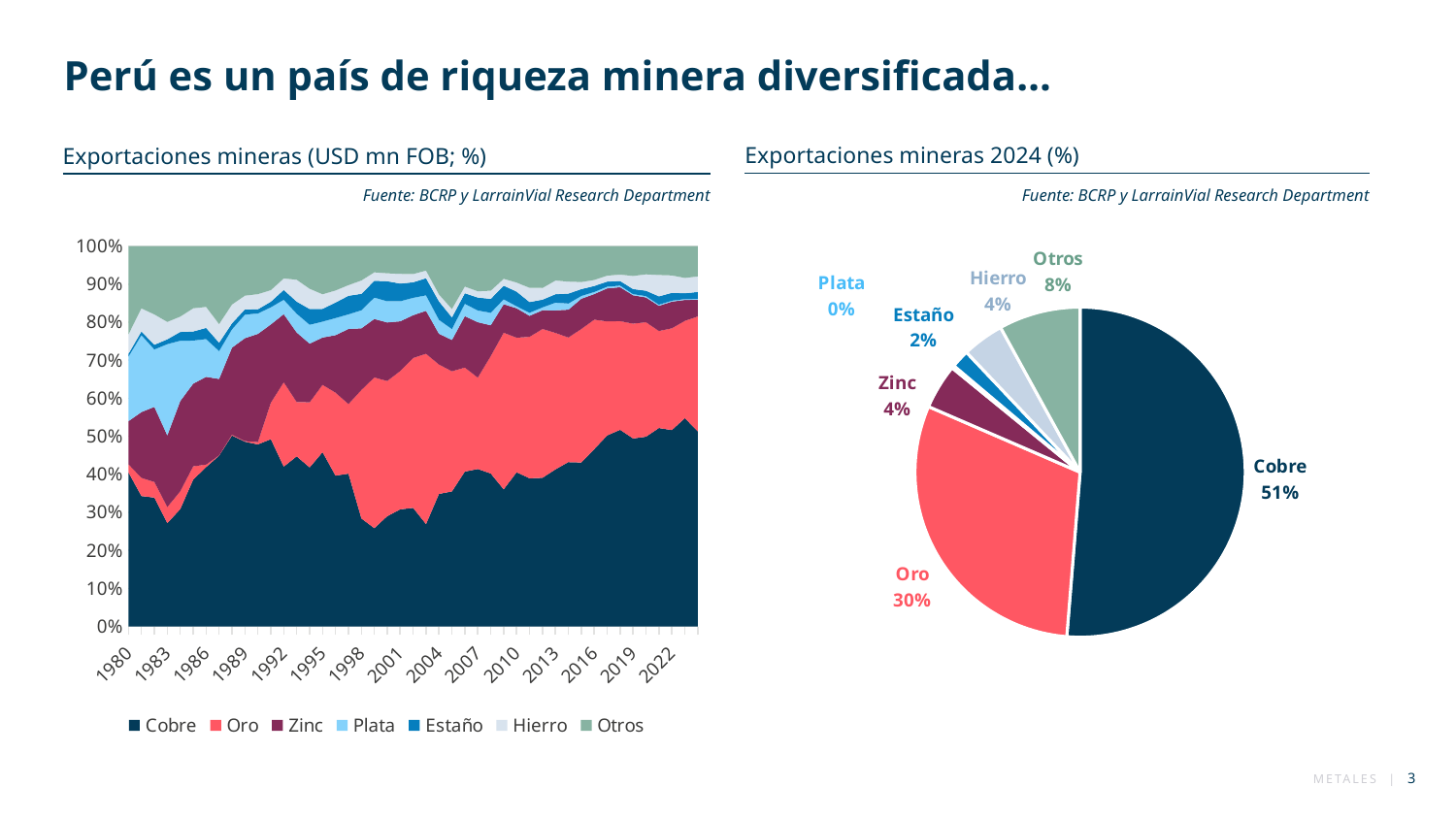
In the pie chart 'Exportaciones mineras 2024 (%)', what share does Cobre have? 51% What kind of chart is the left chart 'Exportaciones mineras (USD mn FOB; %)'? Stacked area chart In the pie chart 'Exportaciones mineras 2024 (%)', what share does Estaño have? 2% How many series does the legend of the left chart 'Exportaciones mineras (USD mn FOB; %)' list? 7 In the pie chart 'Exportaciones mineras 2024 (%)', what share does Otros have? 8% In the pie chart 'Exportaciones mineras 2024 (%)', what is the difference in percentage points between Cobre and Oro? 21 percentage points In the pie chart 'Exportaciones mineras 2024 (%)', what share does Oro have? 30% In the pie chart 'Exportaciones mineras 2024 (%)', which metal has the smallest share? Plata In the pie chart 'Exportaciones mineras 2024 (%)', which is larger, Otros or Hierro? Otros How many slices are labelled in the pie chart 'Exportaciones mineras 2024 (%)'? 7 In the pie chart 'Exportaciones mineras 2024 (%)', which metal has the largest share? Cobre